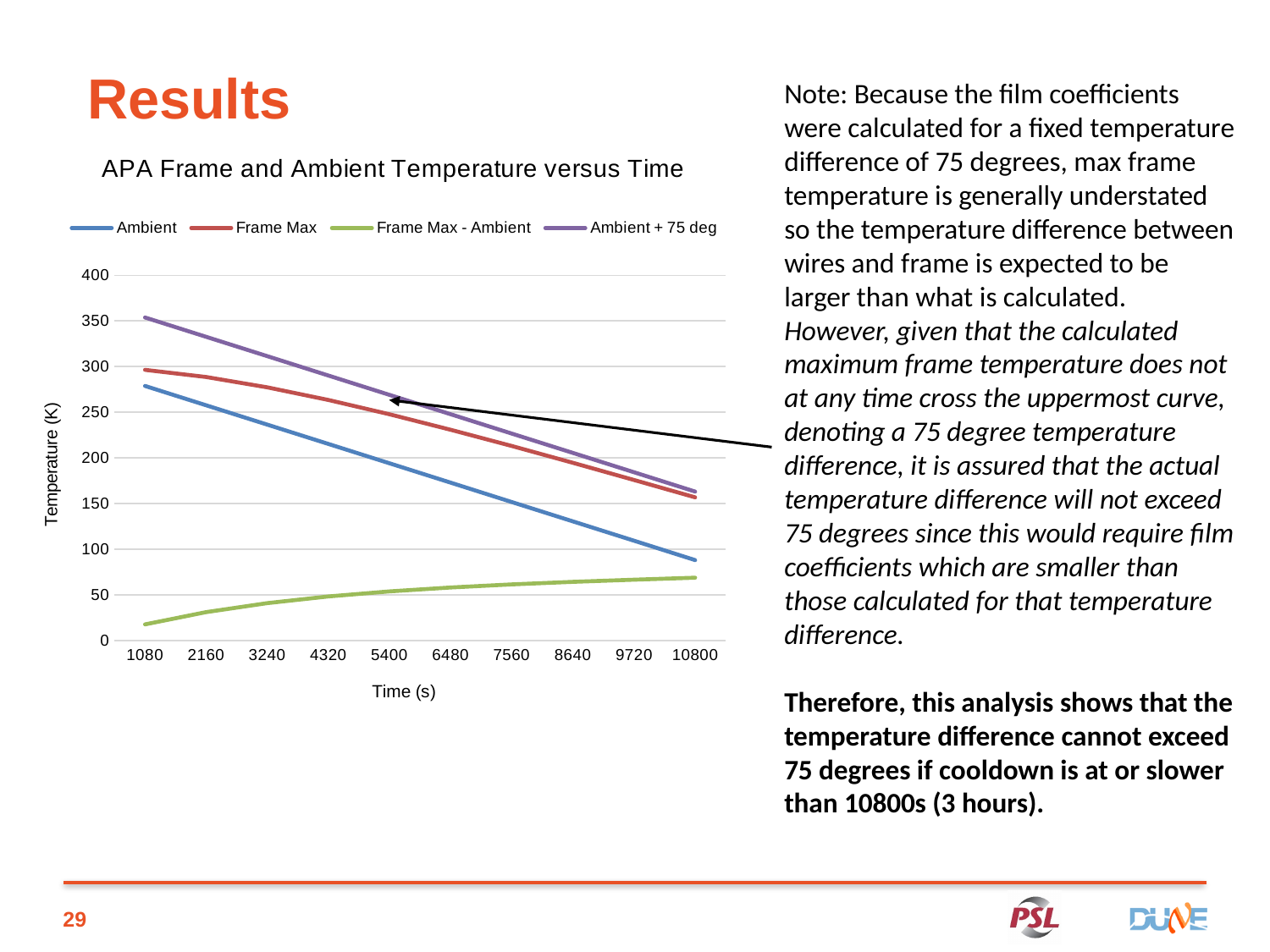
Which series has the highest value at 1080 s? Ambient + 75 deg How many time points are labelled on the x axis of the chart? 10 What is the label of the y axis of the chart? Temperature (K) Does the Frame Max - Ambient series rise or fall as time increases? rise At 10800 s, which is larger: Ambient or Frame Max - Ambient? Ambient Is the value for Ambient at 1080 s greater or less than 250? greater Is the value for Ambient at 10800 s greater or less than 100? less What kind of chart is shown on the slide? line chart How many series does the chart legend list? 4 What is the title of the chart? APA Frame and Ambient Temperature versus Time Which series has the lowest value at 1080 s? Frame Max - Ambient Does the Ambient series rise or fall as time increases? fall